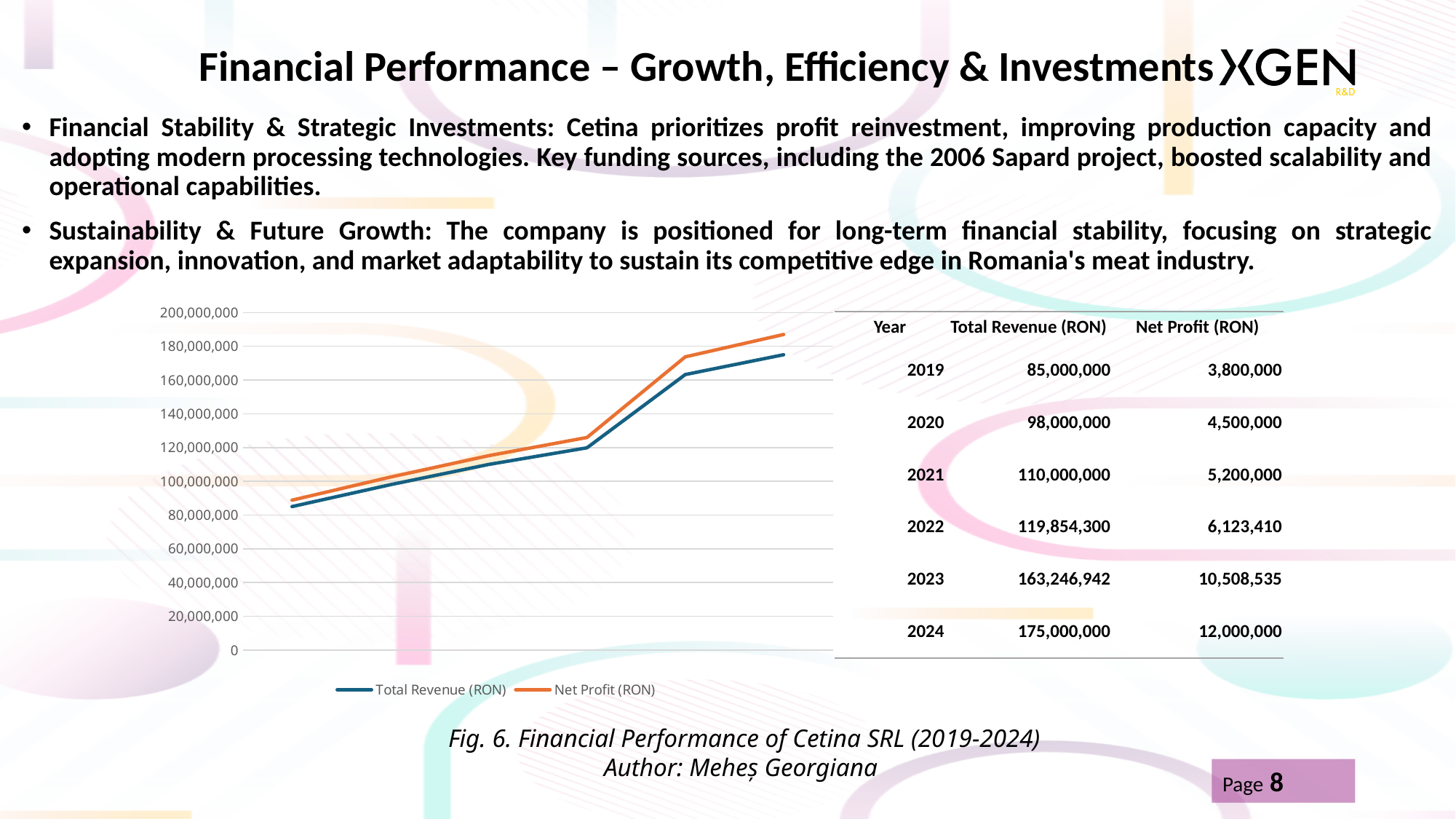
How many years are listed in the table accompanying the chart? 6 How many series does the chart legend list? 2 According to the table, what was the Total Revenue (RON) in 2019? 85,000,000 Does the Total Revenue (RON) line rise or fall from left to right across the chart? rise Which year has the lowest Net Profit (RON) in the table? 2019 According to the table, what was the Net Profit (RON) in 2023? 10,508,535 Is the final point of the Total Revenue (RON) line greater or less than 160,000,000? greater What are the two series named in the chart legend? Total Revenue (RON) and Net Profit (RON) According to the table, which year had the larger Net Profit (RON): 2021 or 2022? 2022 What kind of chart is shown on the slide? line chart What is the difference between Total Revenue (RON) in 2024 and in 2019 according to the table? 90,000,000 Which year has the highest Total Revenue (RON) in the table? 2024